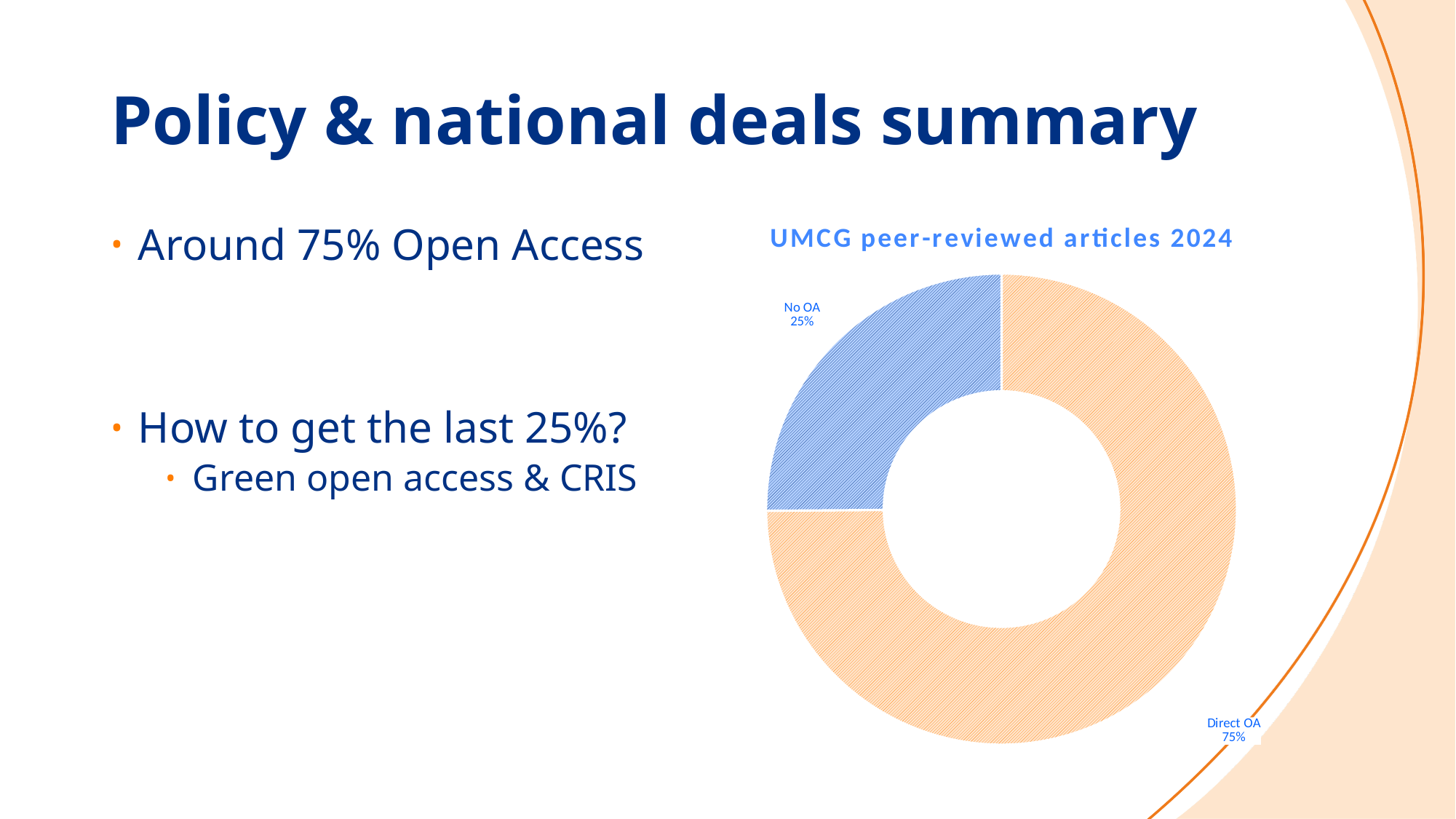
Which is larger, the Direct OA slice or the No OA slice? Direct OA What is the title of the chart? UMCG peer-reviewed articles 2024 How many slices does the chart have? 2 What share of UMCG peer-reviewed articles in 2024 is labelled Direct OA? 75% What share of UMCG peer-reviewed articles in 2024 is labelled No OA? 25% Which slice of the chart is the smallest? No OA What is the difference in percentage points between the Direct OA and No OA slices? 50 What is the total of the two slices shown in the chart? 100% What kind of chart is shown on the slide? Doughnut (pie) chart Which slice of the chart is the largest? Direct OA What colour is the No OA slice? Blue